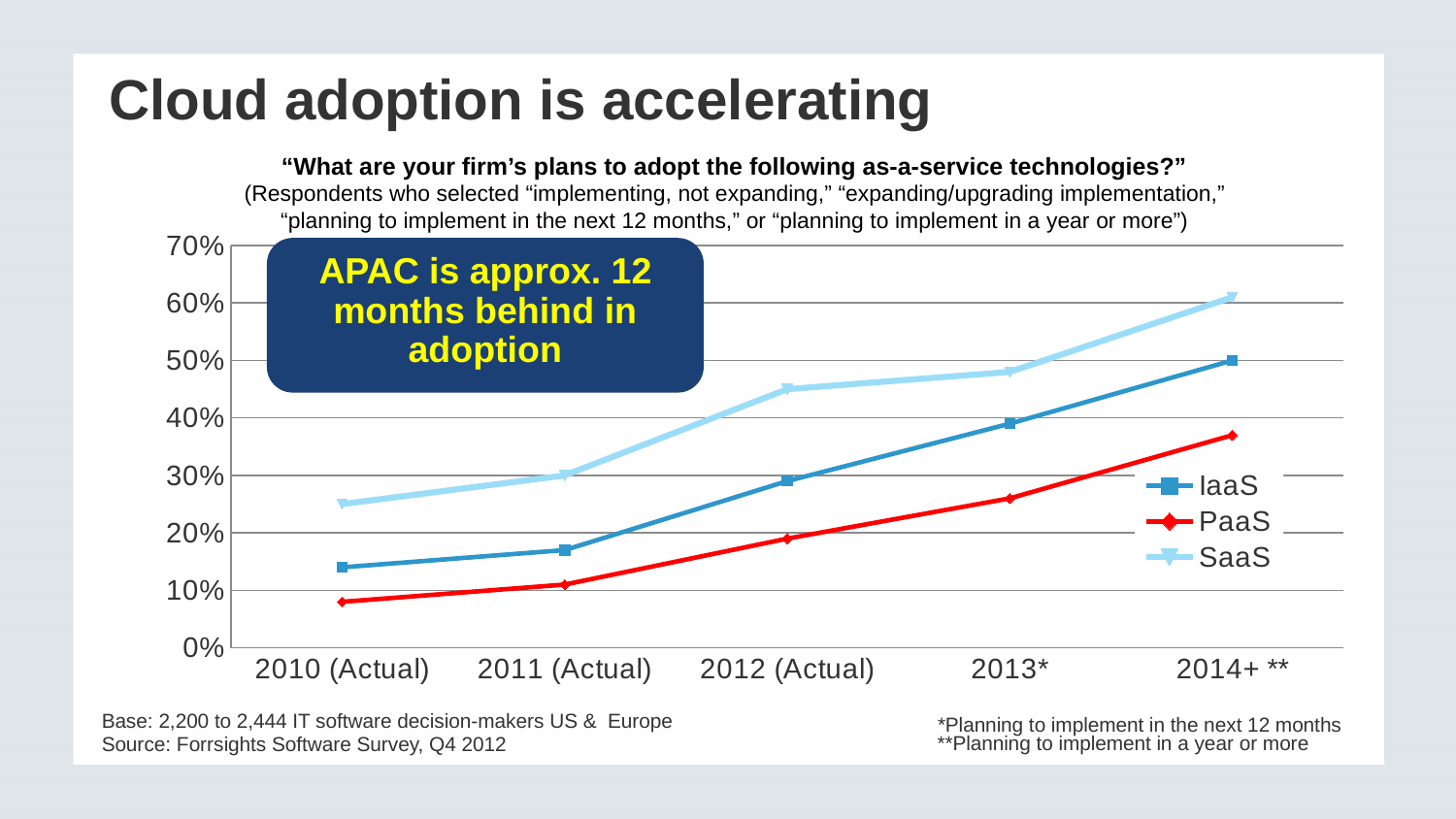
In 2013*, which is larger: the value for IaaS or the value for PaaS? IaaS Which series has the lowest value in 2010 (Actual)? PaaS Which series has the highest value at 2014+ **? SaaS Is the value for PaaS in 2010 (Actual) greater or less than 10%? less Is the value for SaaS in 2012 (Actual) greater or less than 40%? greater What kind of chart is shown on the slide? line chart How many series does the legend list? 3 Is the value for IaaS in 2013* greater or less than 30%? greater Does the IaaS line rise or fall from 2010 (Actual) to 2014+ **? rise What is the title of the slide containing the chart? Cloud adoption is accelerating How many time periods are shown along the x axis? 5